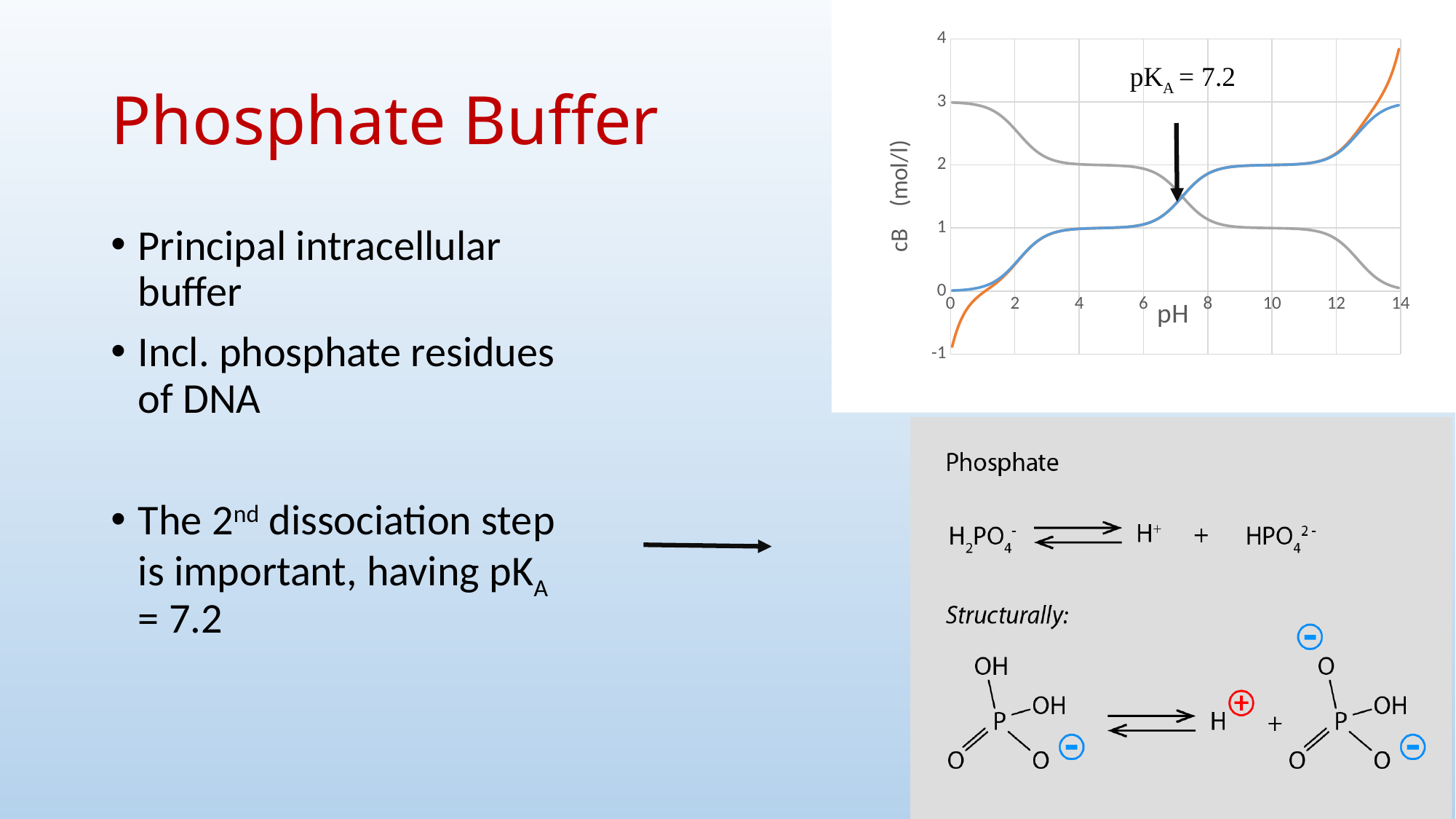
Is the value of the grey line at pH 10 greater or less than 2? less What kind of chart is shown on the slide? line chart Is the value of the orange line at pH 0 greater or less than 0? less What is the label of the x axis of the chart? pH Is the value of the blue line at pH 14 greater or less than 2? greater At pH 2, which line has the higher value, the blue line or the grey line? grey line Does the blue line rise or fall as pH increases along the x axis? rise What pKA value is annotated on the chart? pKA = 7.2 Does the grey line rise or fall as pH increases along the x axis? fall How many lines are plotted on the chart? 3 At pH 12, which line has the higher value, the blue line or the grey line? blue line What is the label of the y axis of the chart? cB (mol/l)